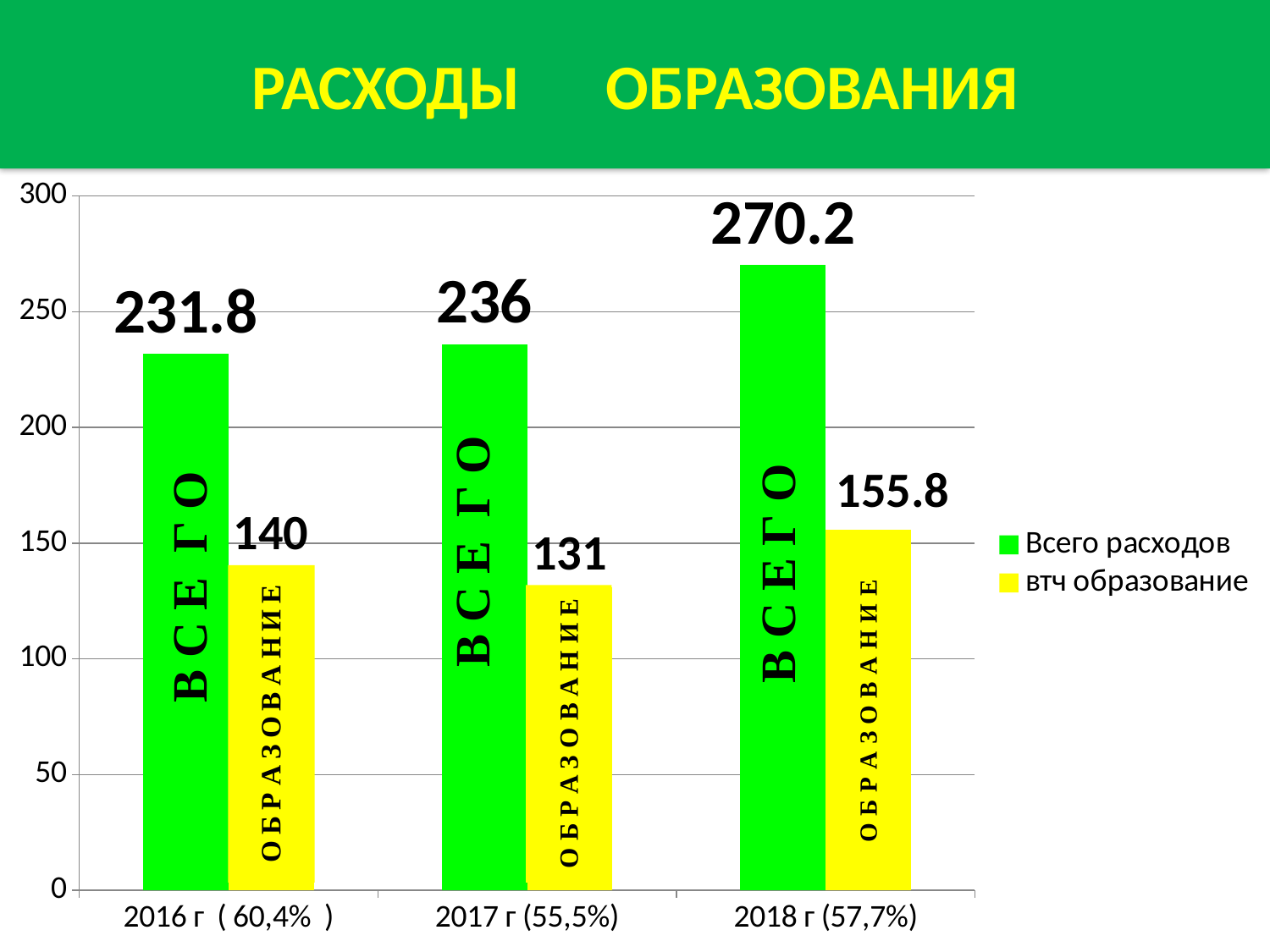
What is the value of "Всего расходов" for 2016 г? 231.8 What is the value of "втч образование" for 2018 г? 155.8 In which year is "втч образование" lowest? 2017 г What is the difference between "Всего расходов" and "втч образование" in 2016 г? 91.8 What is the value of "Всего расходов" for 2018 г? 270.2 How many series does the legend list? 2 Which colour represents "втч образование" in the chart? Yellow What kind of chart is shown on the slide? Bar chart Which is larger: "втч образование" in 2016 г or in 2017 г? 2016 г How many years (categories) are shown on the x axis? 3 In which year is "Всего расходов" highest? 2018 г What is the value of "втч образование" for 2017 г? 131